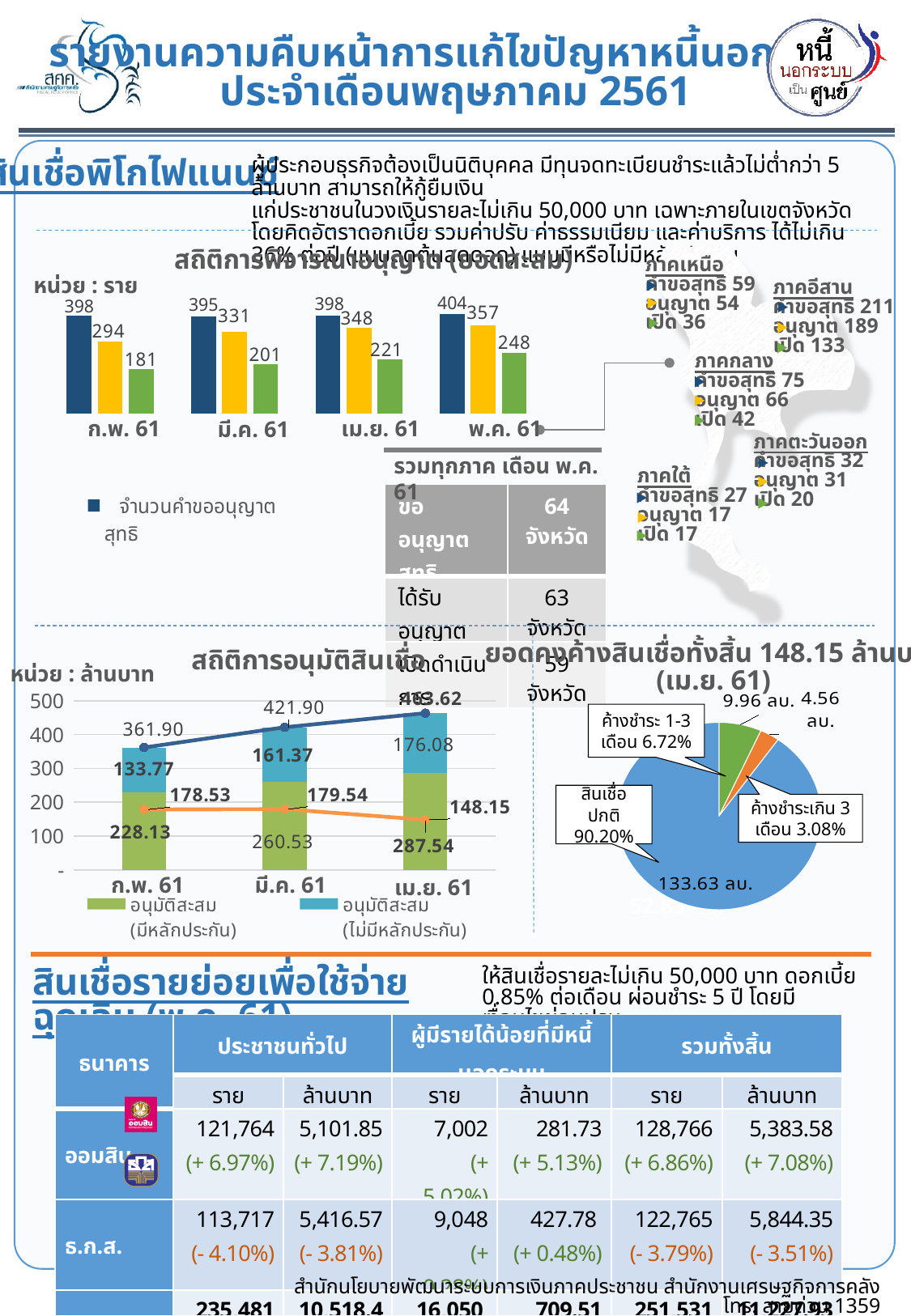
What kind of chart is the top chart titled สถิติการพิจารณาอนุญาต? bar chart In the bottom-left chart (สถิติการอนุมัติสินเชื่อ), what is the total of the stacked bar for เม.ย. 61? 463.62 In the bottom-left chart (สถิติการอนุมัติสินเชื่อ), what is the value of อนุมัติสะสม (มีหลักประกัน) for มี.ค. 61? 260.53 In the pie chart (ยอดคงค้างสินเชื่อทั้งสิ้น 148.15 ล้านบาท), which slice is the smallest? ค้างชำระเกิน 3 เดือน How many series does the legend of the bottom-left chart (สถิติการอนุมัติสินเชื่อ) list? 2 In the pie chart (ยอดคงค้างสินเชื่อทั้งสิ้น 148.15 ล้านบาท), what share does สินเชื่อปกติ have? 90.20% In the top bar chart (สถิติการพิจารณาอนุญาต), which month has the highest value for จำนวนคำขออนุญาตสุทธิ (dark blue bars)? พ.ค. 61 In the top bar chart (สถิติการพิจารณาอนุญาต), what is the value of the green bar for ก.พ. 61? 181 In the top bar chart (สถิติการพิจารณาอนุญาต), what is the difference between the dark blue bar and the yellow bar for ก.พ. 61? 104 In the bottom-left chart (สถิติการอนุมัติสินเชื่อ), do the values of อนุมัติสะสม (มีหลักประกัน) rise or fall from ก.พ. 61 to เม.ย. 61? rise How many months are shown on the x axis of the top bar chart (สถิติการพิจารณาอนุญาต)? 4 In the top bar chart (สถิติการพิจารณาอนุญาต), what is the value of the dark blue bar (จำนวนคำขออนุญาตสุทธิ) for พ.ค. 61? 404